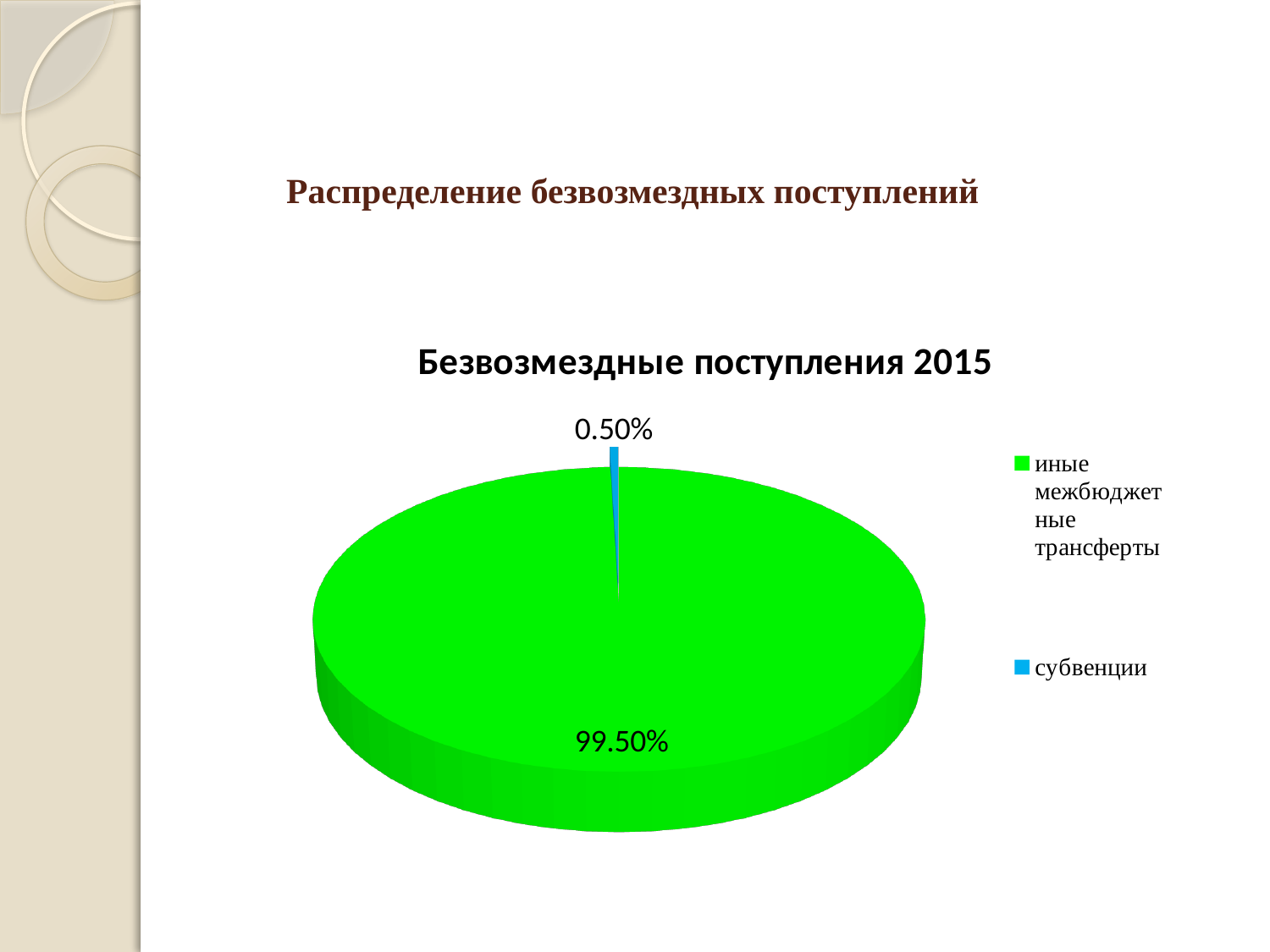
What share of the pie does "субвенции" take? 0.50% Which is larger, the slice for "субвенции" or the slice for "иные межбюджетные трансферты"? иные межбюджетные трансферты What kind of chart is shown on the slide? pie chart Which category has the smallest slice of the pie? субвенции What share of the pie does "иные межбюджетные трансферты" take? 99.50% What is the difference in percentage points between the "иные межбюджетные трансферты" slice and the "субвенции" slice? 99.00 percentage points What is the title of the chart? Безвозмездные поступления 2015 What colour is the slice for "субвенции"? blue How many entries does the legend list? 2 Which category has the largest slice of the pie? иные межбюджетные трансферты How many slices does the pie chart have? 2